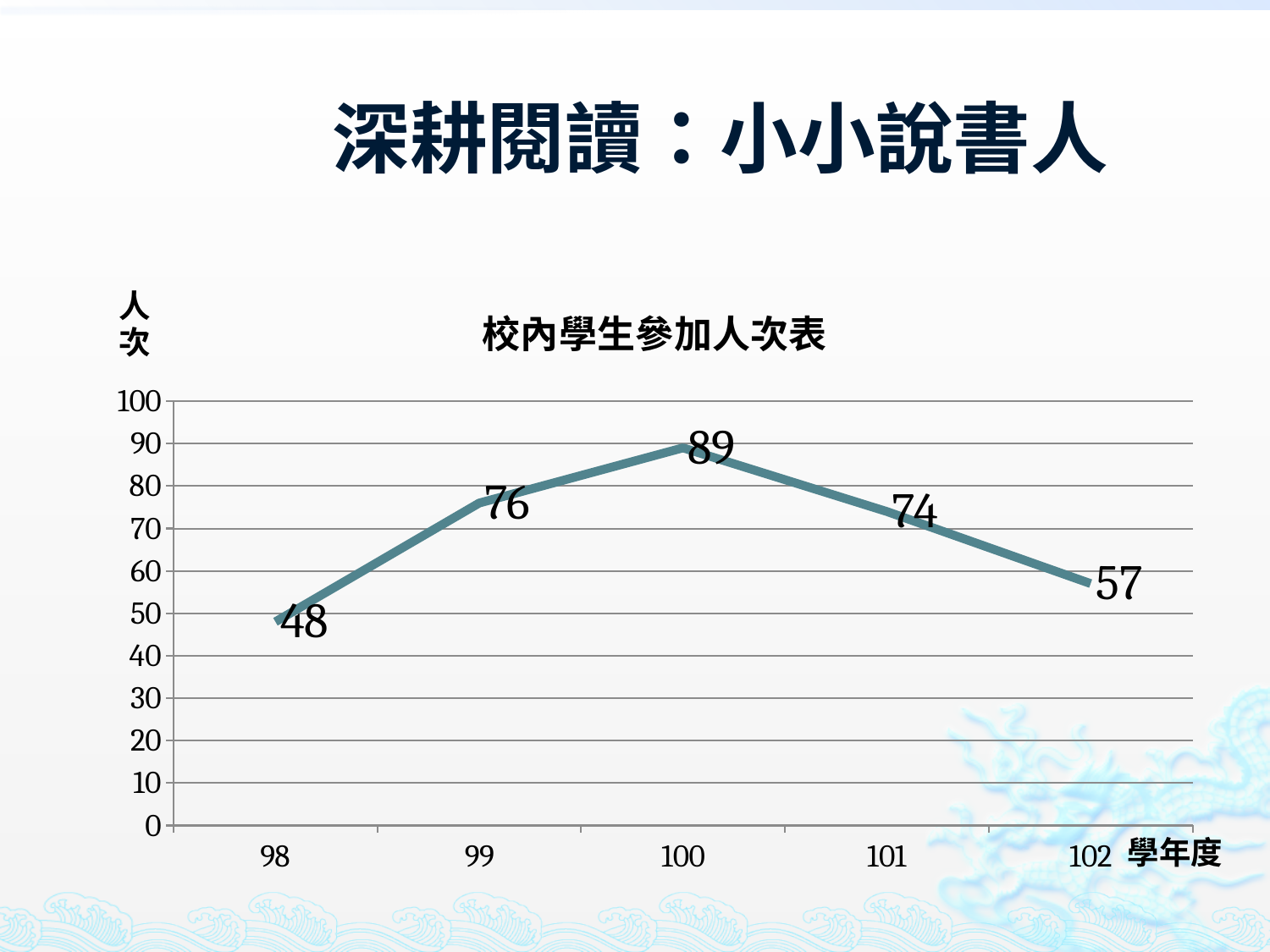
What is the value for academic year 98? 48 How many academic years are plotted on the chart? 5 Which academic year has the lowest value? 98 What is the difference between the values for academic years 100 and 98? 41 What is the title of the chart? 校內學生參加人次表 Which is larger, the value for academic year 99 or academic year 101? 99 Which academic year has the highest value? 100 What is the value for academic year 102? 57 What is the difference between the values for academic years 101 and 102? 17 Is the value for academic year 101 greater or less than 70? greater What kind of chart is shown on the slide? line chart What is the value for academic year 100? 89